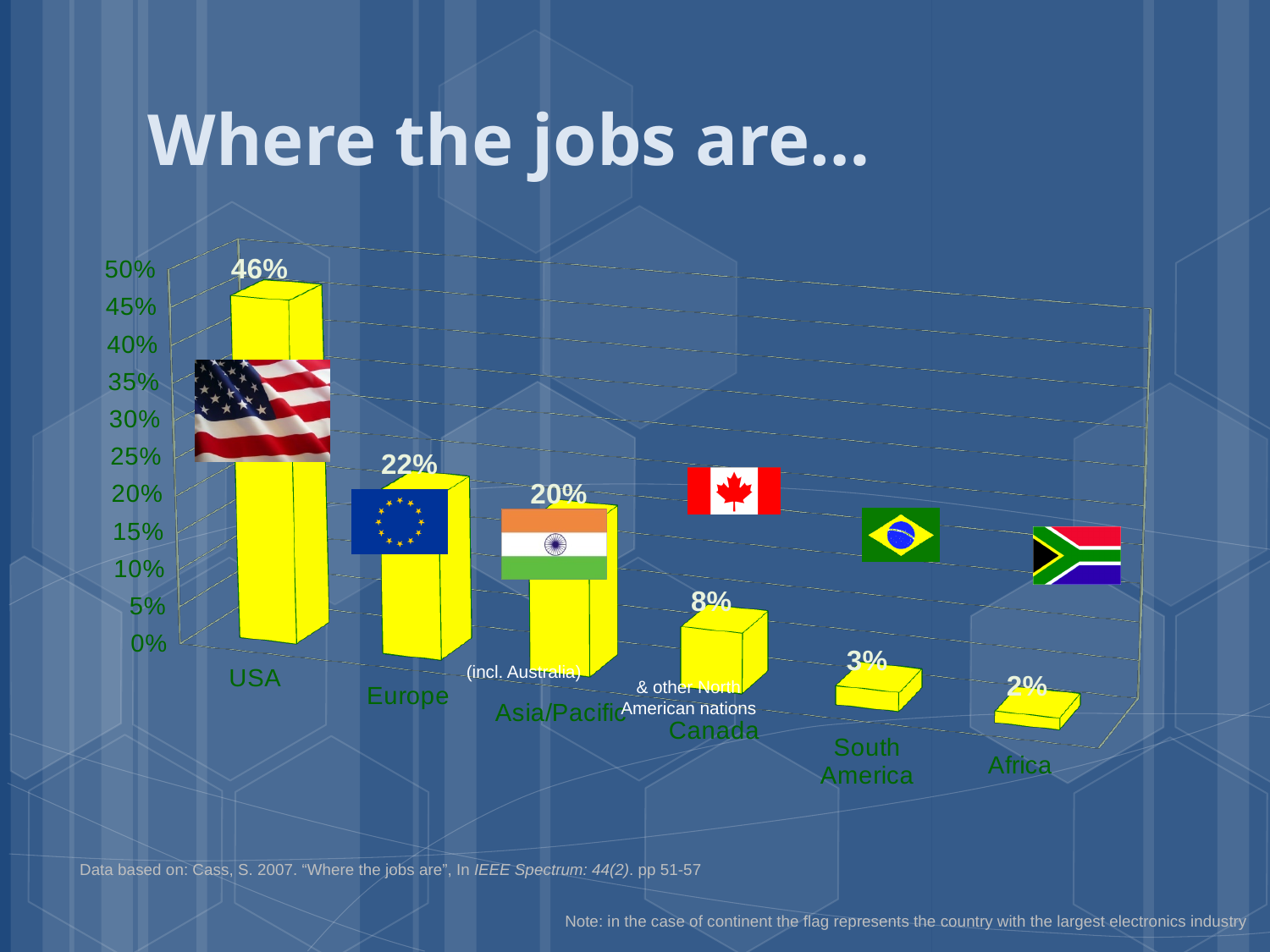
Which region has the highest share of jobs? USA What kind of chart is shown on the slide? Bar chart What is the difference between the USA and Europe values? 24% What value is shown for Europe? 22% Which is larger, the value for Canada or the value for South America? Canada What is the title of the slide? Where the jobs are… How many regions are shown on the chart? 6 What value is shown for Africa? 2% What value is shown for Asia/Pacific? 20% Which region has the lowest share of jobs? Africa What percentage of jobs does the chart show for the USA? 46% What value is shown for Canada? 8%